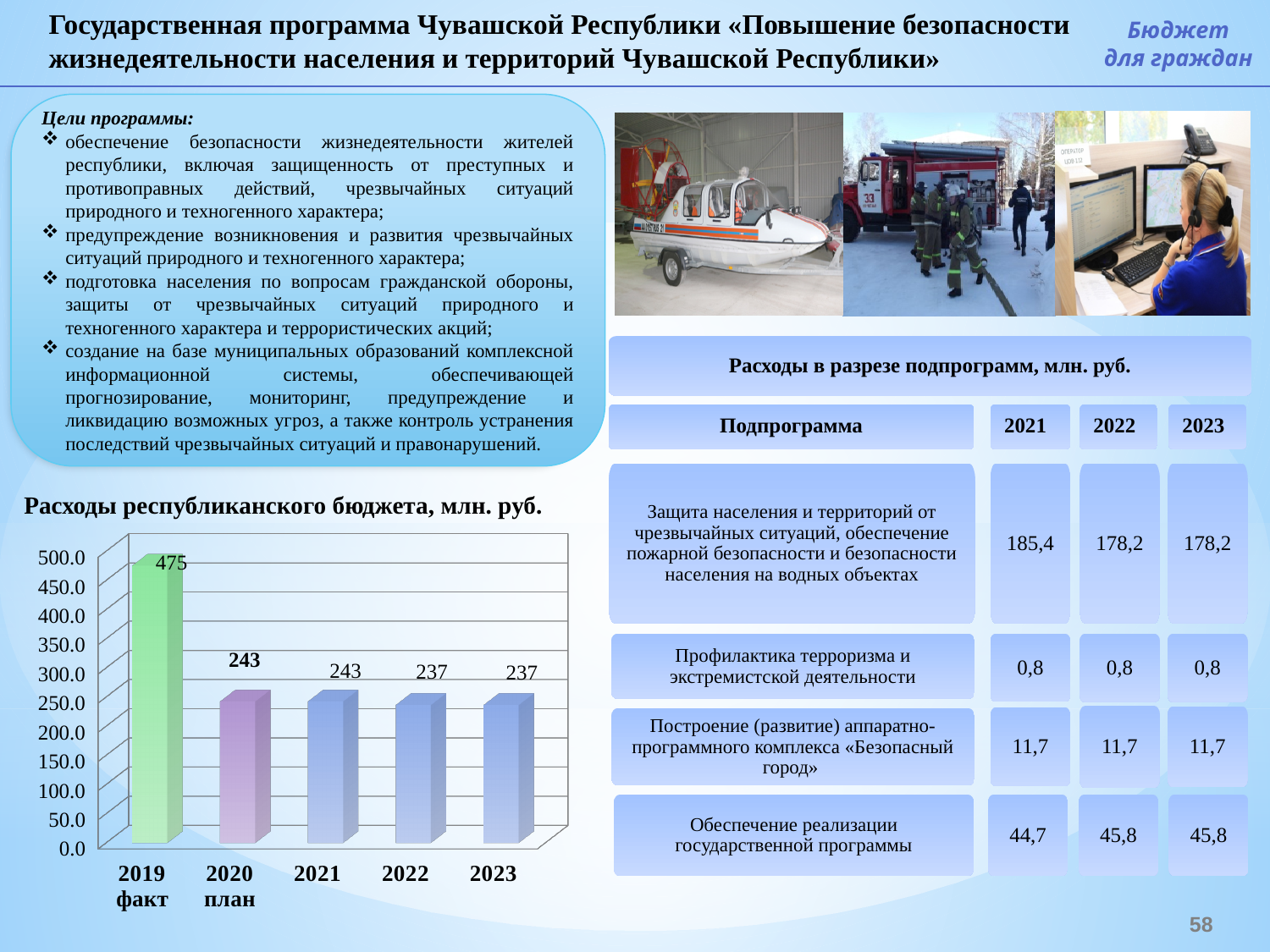
Which category has the highest value in the chart? 2019 факт What is the value for 2020 план in the chart? 243 What kind of chart is shown on the slide? bar chart What is the title of the chart on the slide? Расходы республиканского бюджета, млн. руб. What is the value for 2019 факт in the chart 'Расходы республиканского бюджета, млн. руб.'? 475 What is the difference between the values for 2019 факт and 2020 план? 232 How many categories are shown on the x axis of the chart? 5 Is the value for 2019 факт greater or less than 450.0? greater What is the value for 2022 in the chart? 237 Which is larger, the value for 2019 факт or the value for 2021? 2019 факт What is the value for 2023 in the chart? 237 What is the difference between the values for 2021 and 2022? 6